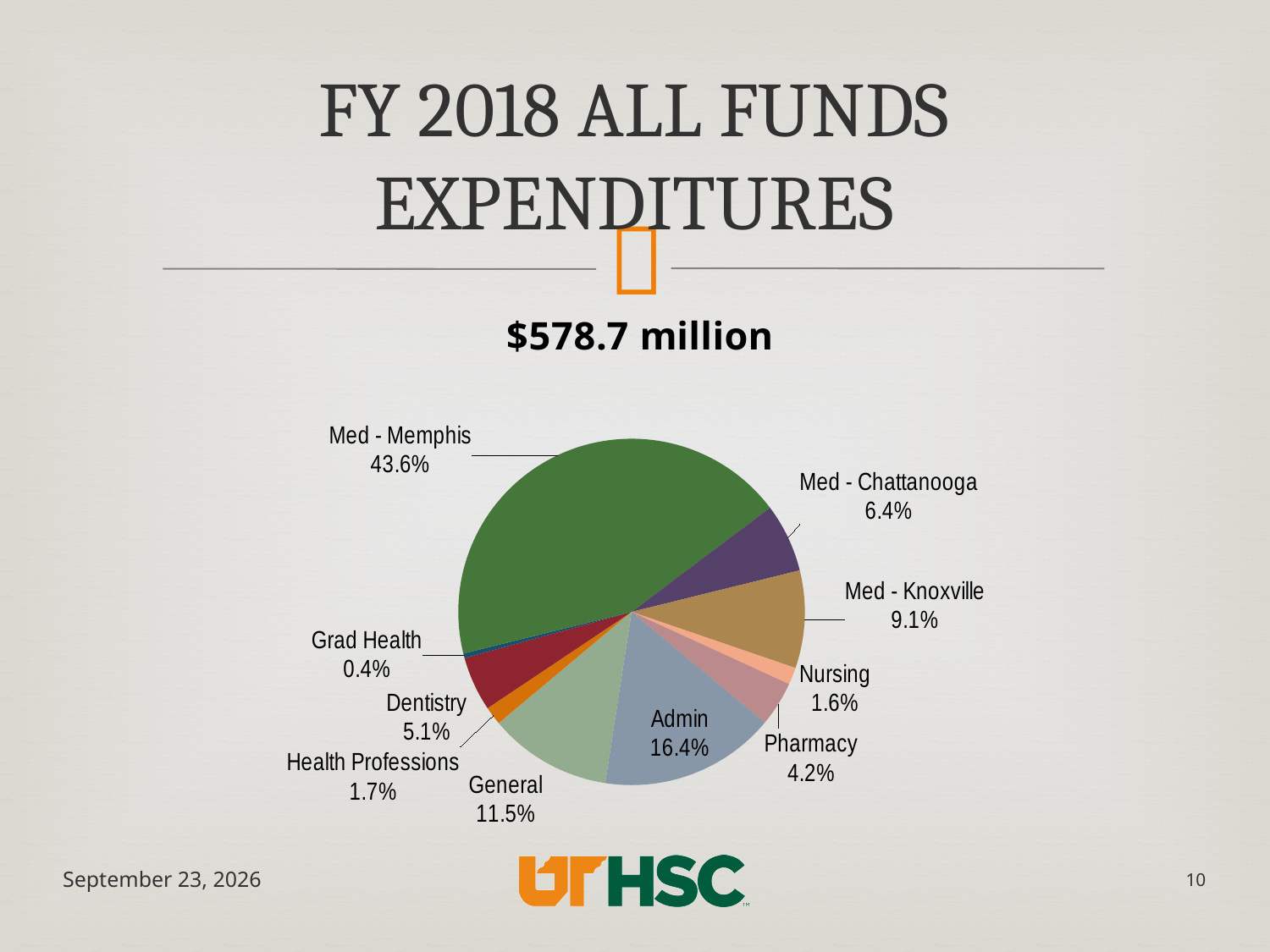
Which category has the smallest slice of the pie? Grad Health Which category has the largest slice of the pie? Med - Memphis What share of FY 2018 all funds expenditures is Med - Memphis? 43.6% What is the difference in percentage points between Admin and General? 4.9 Which is larger, the share for Med - Chattanooga or the share for Dentistry? Med - Chattanooga What percentage is shown for Pharmacy? 4.2% How many categories are shown in the pie chart? 10 What share does Med - Knoxville account for? 9.1% What percentage of expenditures is labelled for Admin? 16.4% What kind of chart is shown on the slide? pie chart What is the combined share of Nursing and Health Professions? 3.3% What total amount of expenditures is stated above the pie chart? $578.7 million